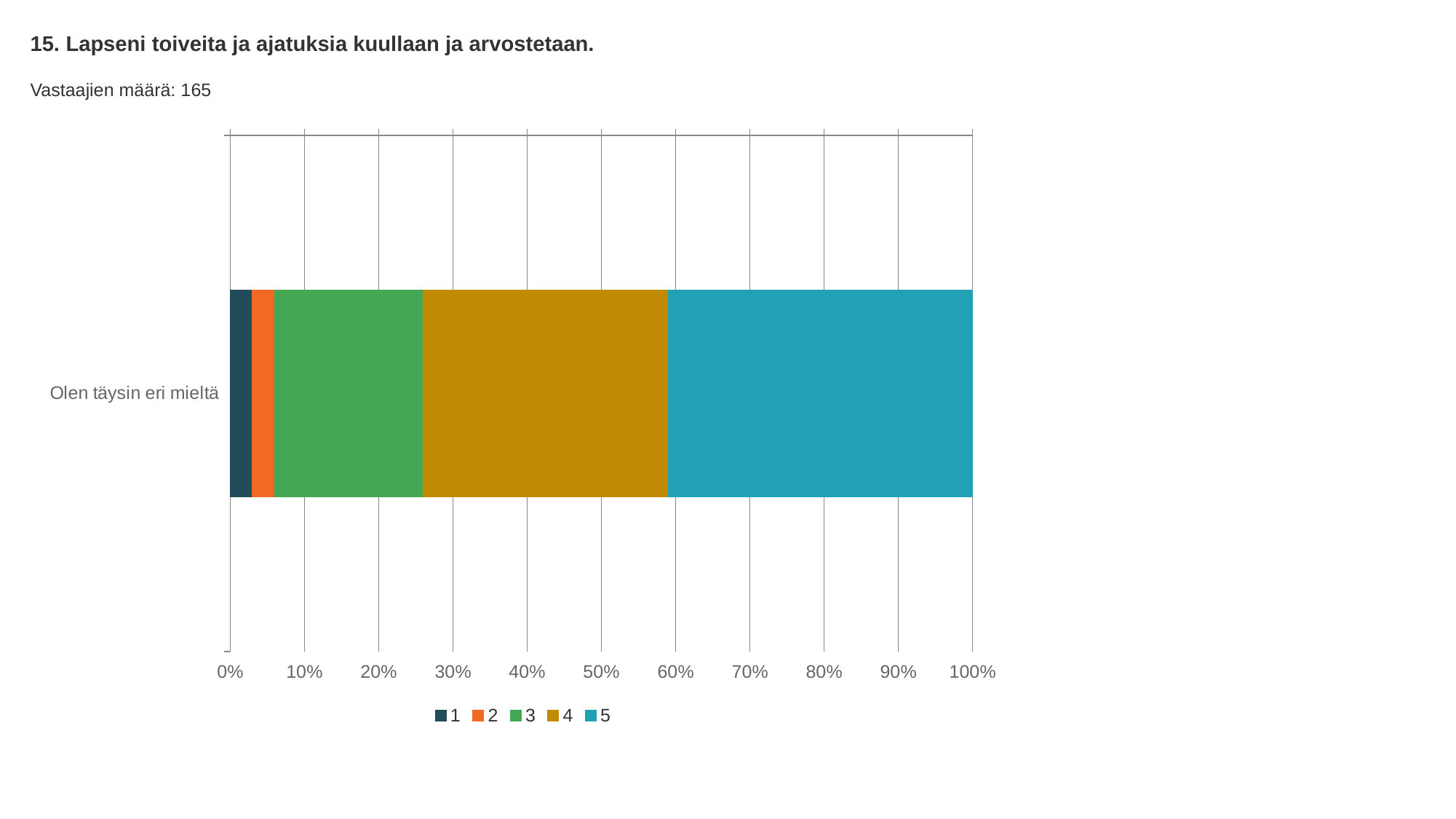
Is the share for series 5 greater or less than 30%? greater How many respondents (Vastaajien määrä) are reported on the slide? 165 Which segment is larger, series 5 or series 3? 5 Is the share for series 4 greater or less than 30%? greater How many series does the legend list? 5 Is the share for series 3 greater or less than 10%? greater What is the title of the chart? 15. Lapseni toiveita ja ajatuksia kuullaan ja arvostetaan. Which segment is larger, series 3 or series 4? 4 Which series occupies the largest segment of the bar? 5 How many bars (categories) are plotted in the chart? 1 What kind of chart is shown on the slide? Stacked bar chart